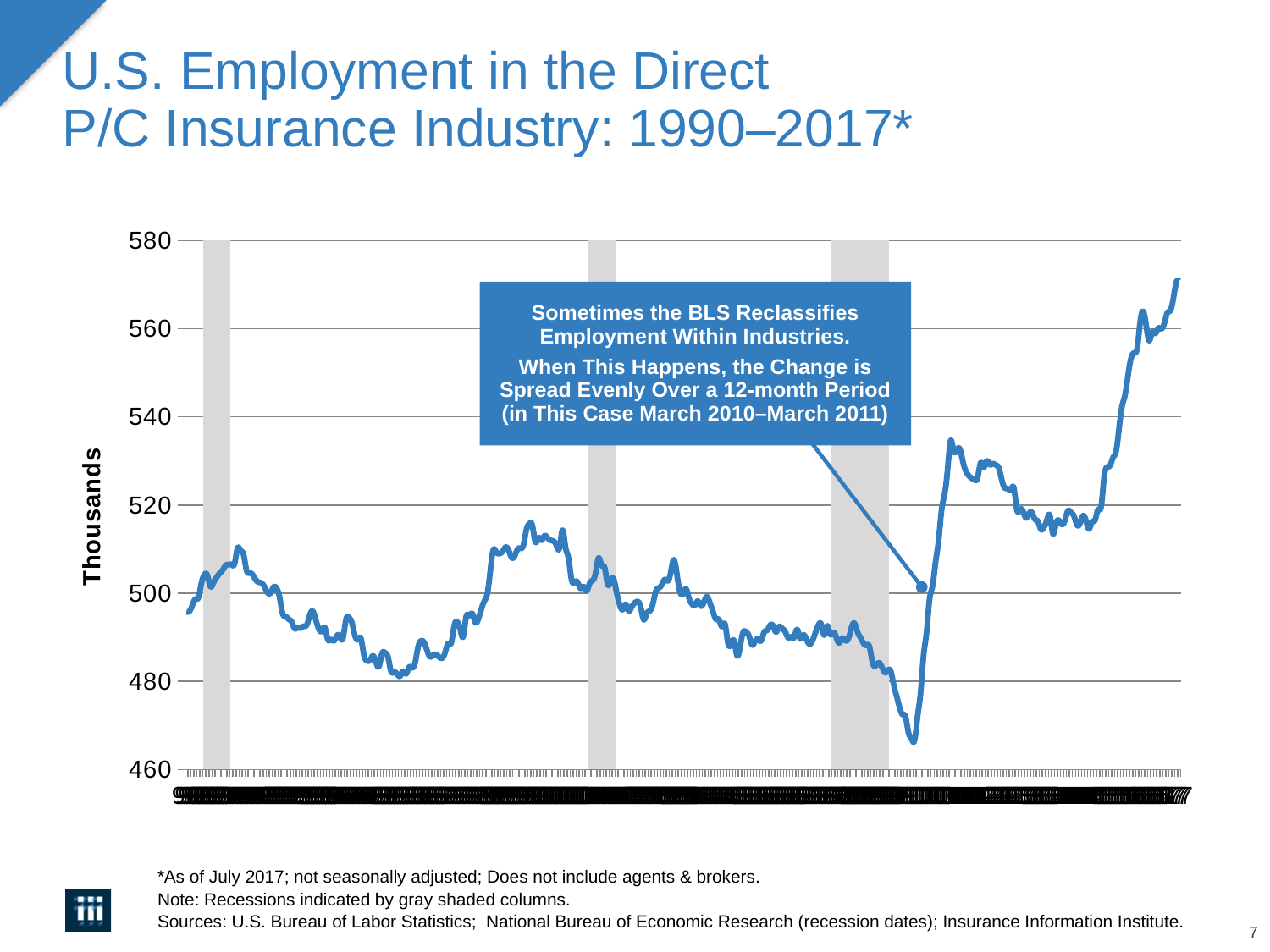
Which is larger: the value at the final point of the line or the value at the first point of the line? The final point How many gray shaded recession columns appear on the chart? 3 What is the label on the vertical axis of the chart? Thousands Comparing the start of the line to its end, does employment rise or fall over the full period? rise Is the lowest point of the line greater or less than 480? less Is the value at the first point of the line (start of 1990) greater or less than 500? less What is the highest value shown on the vertical axis? 580 Is the highest point of the line greater or less than 580? less How many data series are plotted on the chart? 1 What kind of chart is shown on the slide? Line chart